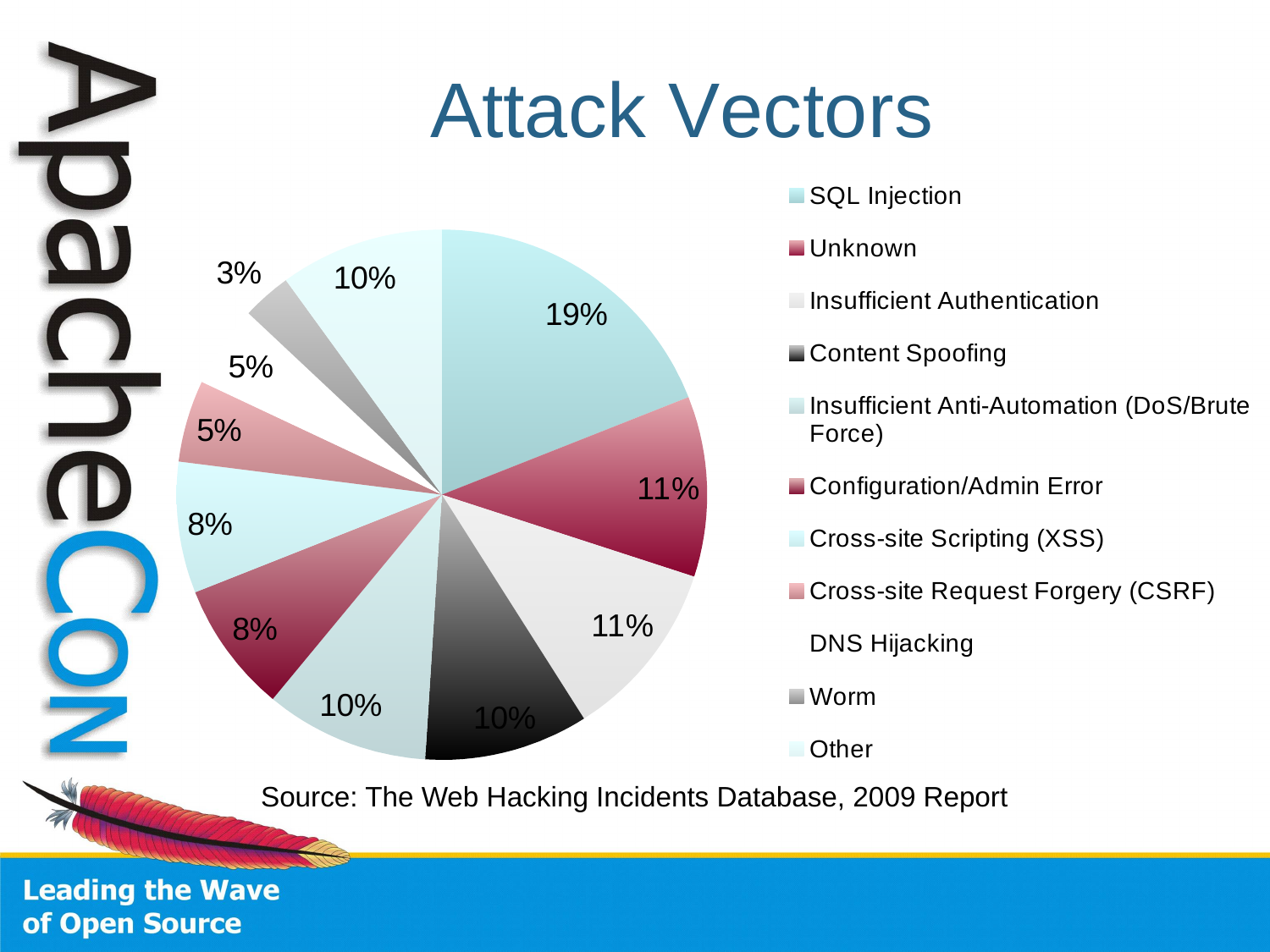
Which attack vector has the largest slice of the pie? SQL Injection What percentage is shown for Content Spoofing? 10% Which is larger, the slice for Unknown or the slice for Content Spoofing? Unknown What kind of chart is shown on the slide? Pie chart What source is cited for the chart data? The Web Hacking Incidents Database, 2009 Report How many attack vector categories does the legend list? 11 Which attack vector has the smallest slice of the pie? Worm What is the title of the chart? Attack Vectors What percentage is shown for Unknown? 11% What is the difference in percentage points between SQL Injection and Worm? 16 percentage points What percentage is shown for Worm? 3% What share of the pie does SQL Injection account for? 19%